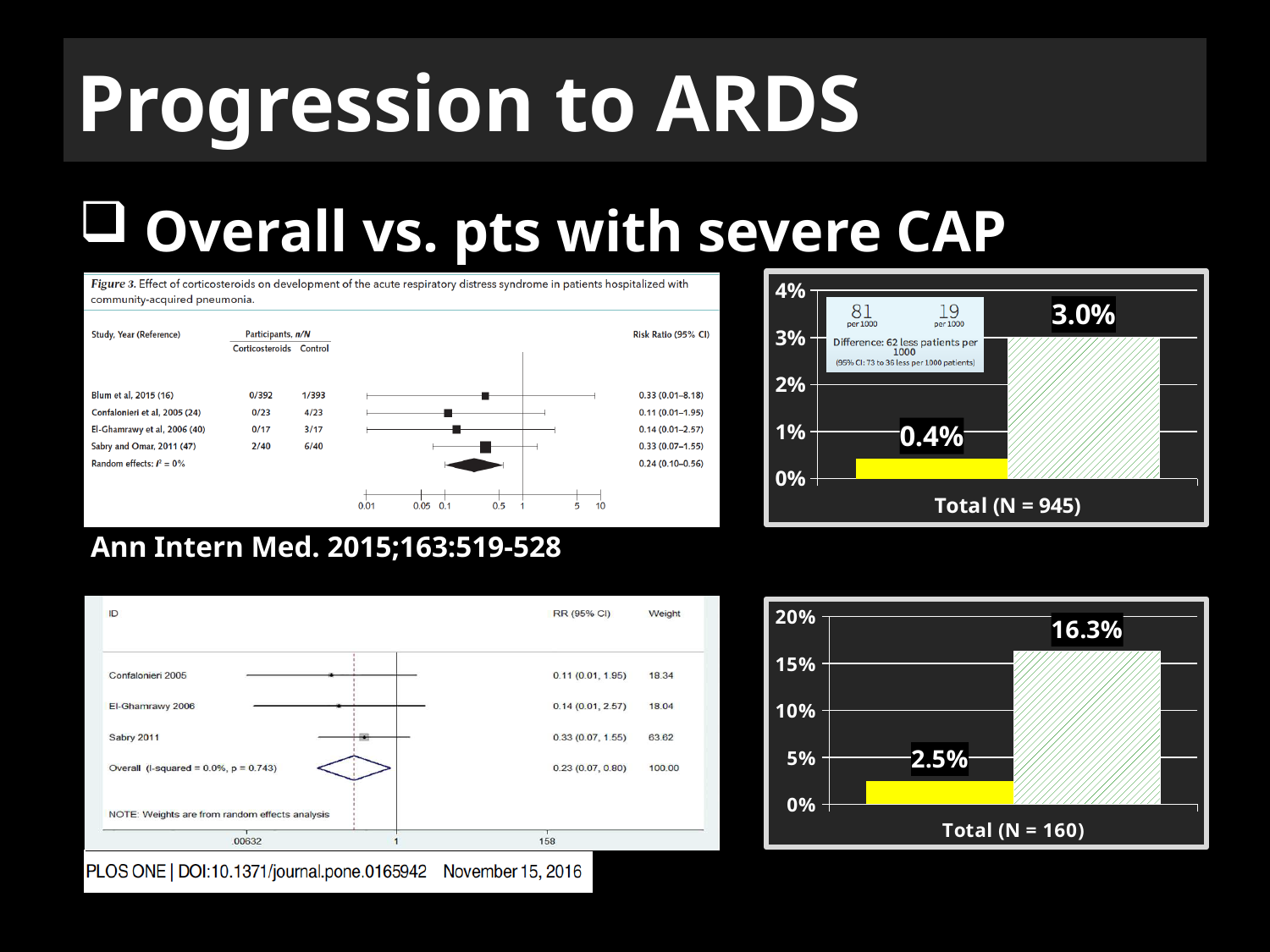
In the bottom-right chart titled 'Total (N = 160)', is the value of the yellow bar greater or less than 5%? less In the top-right chart titled 'Total (N = 945)', what value is shown on the hatched bar? 3.0% In the top-right chart titled 'Total (N = 945)', what is the difference between the hatched bar and the yellow bar? 2.6% What is the highest value shown on the y axis of the bottom-right chart titled 'Total (N = 160)'? 20% In the bottom-right chart titled 'Total (N = 160)', which bar is higher, the yellow bar or the hatched bar? the hatched bar In the bottom-right chart titled 'Total (N = 160)', what value is shown on the yellow bar? 2.5% What kind of chart is the top-right chart titled 'Total (N = 945)'? bar chart In the bottom-right chart titled 'Total (N = 160)', what is the difference between the hatched bar and the yellow bar? 13.8% In the top-right chart titled 'Total (N = 945)', is the value of the hatched bar greater or less than 2%? greater In the top-right chart titled 'Total (N = 945)', what value is shown on the yellow bar? 0.4% In the bottom-right chart titled 'Total (N = 160)', what value is shown on the hatched bar? 16.3% How many bars are plotted in the bottom-right chart titled 'Total (N = 160)'? 2